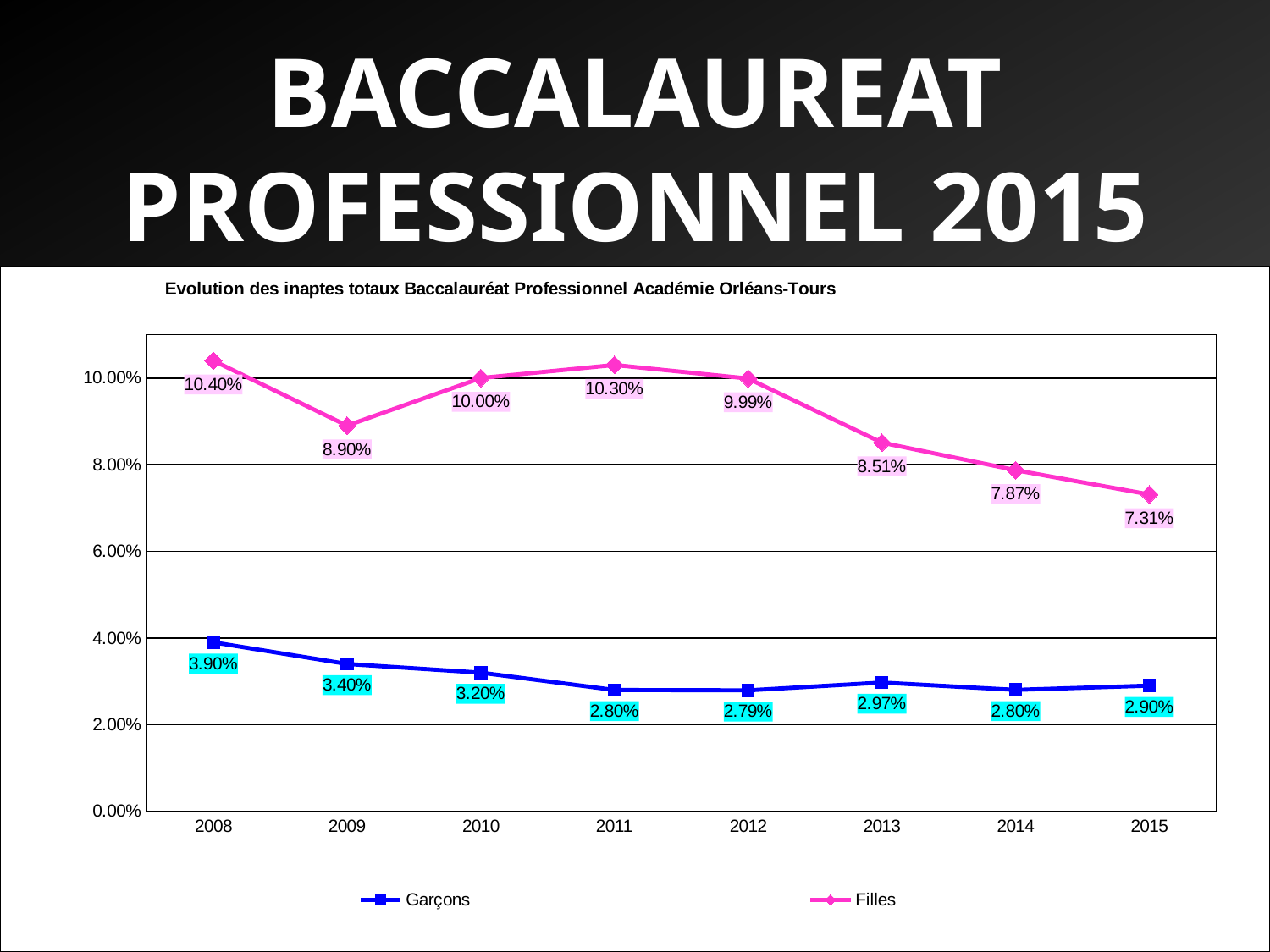
How many years are shown on the x axis? 8 What is the difference between the Filles and Garçons values in 2013? 5.54% What is the title of the chart? Evolution des inaptes totaux Baccalauréat Professionnel Académie Orléans-Tours Does the Filles series rise or fall from 2012 to 2015? Fall Which is larger, the Filles value in 2009 or the Filles value in 2010? 2010 What is the value for Filles in 2015? 7.31% In which year is the Filles series at its lowest? 2015 What is the value for Garçons in 2012? 2.79% What is the value for Filles in 2008? 10.40% How many series does the legend list? 2 In which year is the Garçons series at its highest? 2008 What kind of chart is shown? Line chart